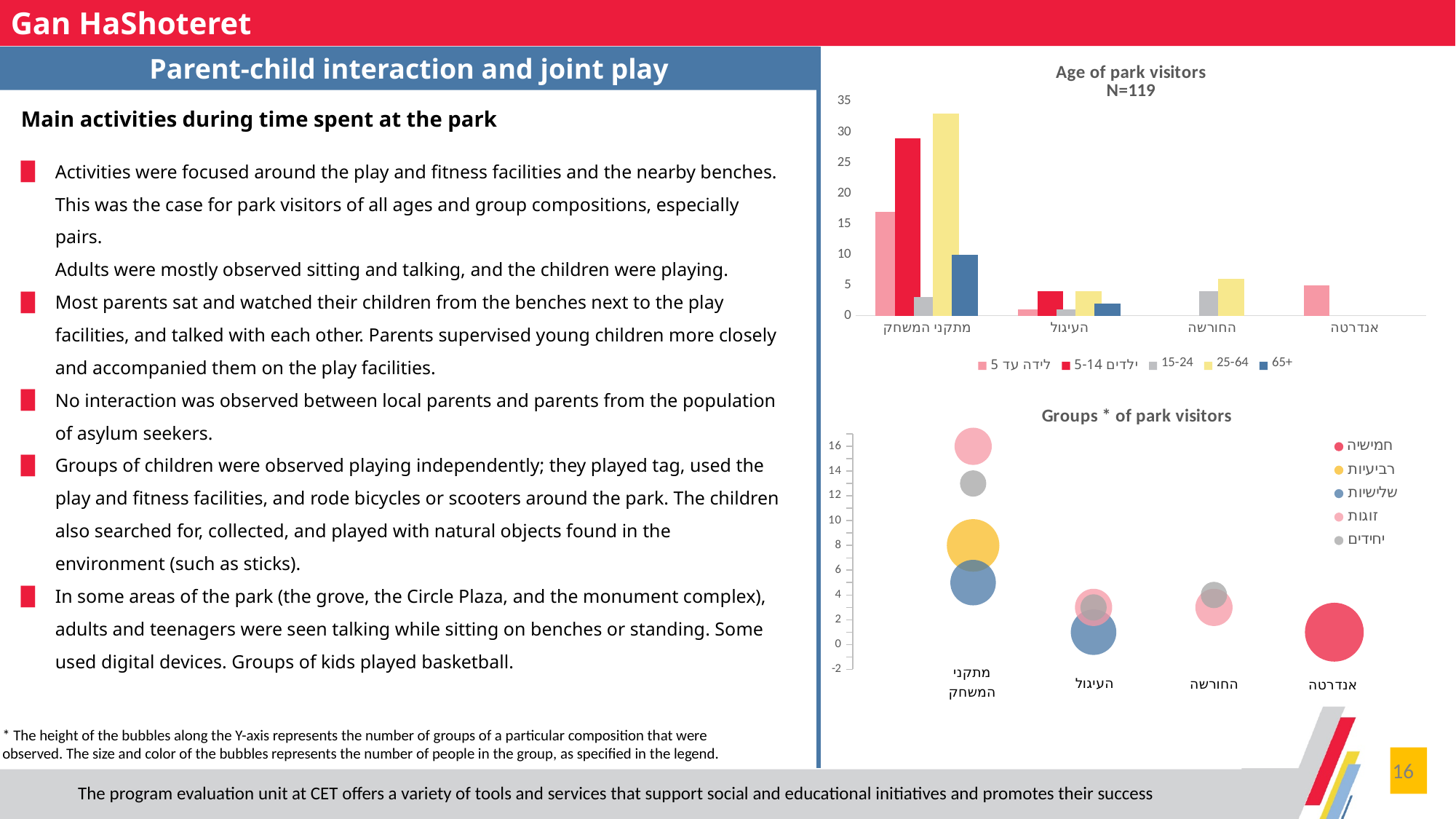
What sample size (N) is stated in the title of the 'Age of park visitors' chart? N=119 What kind of chart is the 'Age of park visitors' chart? bar chart In the 'Age of park visitors' chart, which is larger at מתקני המשחק: the 5-14 ילדים bar or the 15-24 bar? 5-14 ילדים How many locations are shown on the x axis of the 'Groups * of park visitors' chart? 4 In the 'Age of park visitors' chart, is the value for 25-64 at מתקני המשחק greater or less than 30? greater How many group types does the legend of the 'Groups * of park visitors' chart list? 5 How many series does the legend of the 'Age of park visitors' chart list? 5 In the 'Age of park visitors' chart, is the value for 65+ at מתקני המשחק greater or less than 15? less How many categories are shown on the x axis of the 'Age of park visitors' chart? 4 In the 'Age of park visitors' chart, which age group has the tallest bar at מתקני המשחק? 25-64 In the 'Age of park visitors' chart, is the value for 5-14 ילדים at מתקני המשחק greater or less than 25? greater In the 'Age of park visitors' chart, which category has the lowest total number of visitors across all age groups? אנדרטה